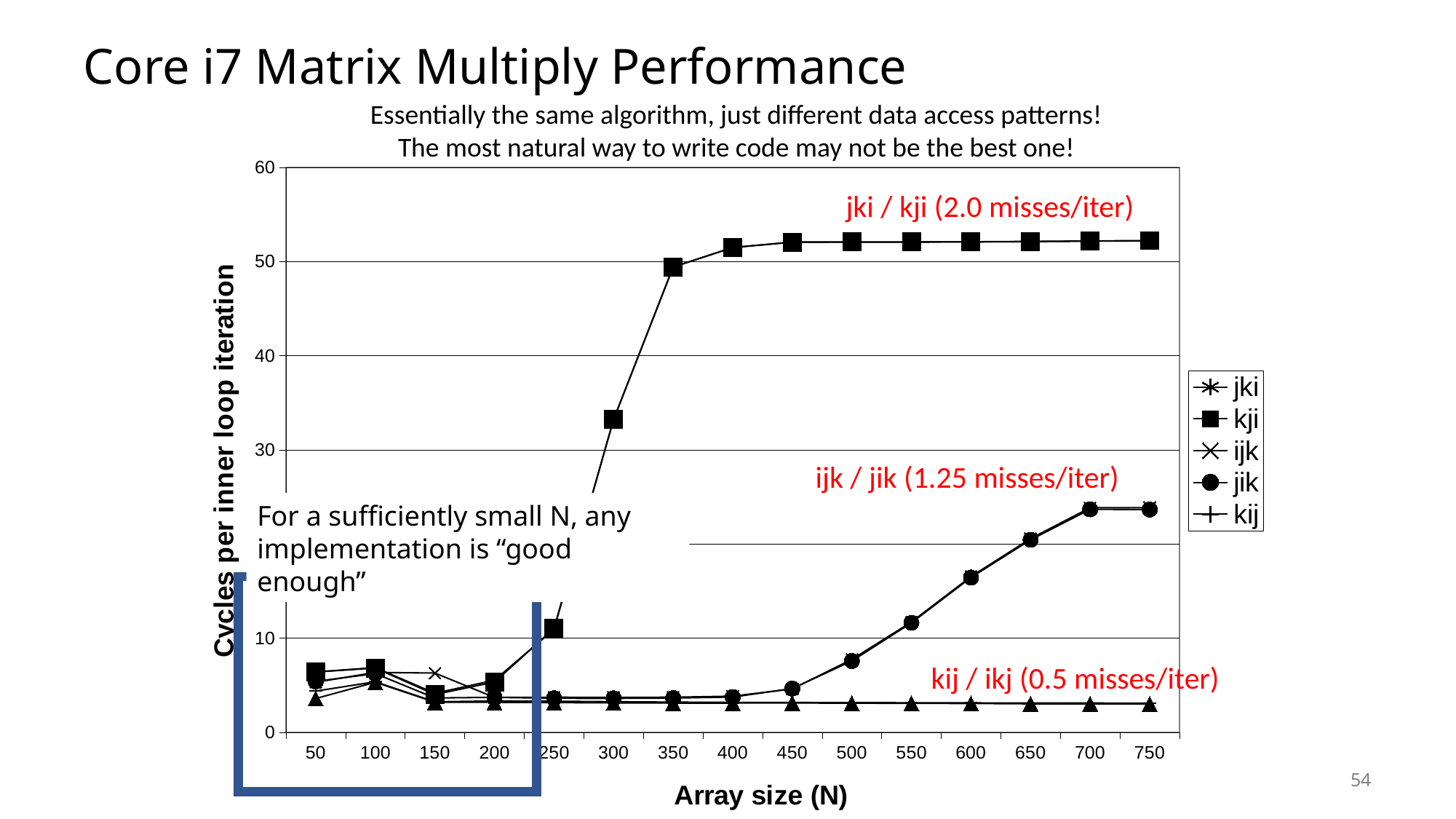
Is the value for kij at N = 750 greater or less than 10? less Is the value for kji at N = 750 greater or less than 50? greater How many array size (N) values are plotted along the x axis? 15 What is the label of the x axis? Array size (N) Is the value for kji at N = 300 greater or less than 30? greater What is the label of the y axis? Cycles per inner loop iteration At N = 750, which series has the higher value, kji or jik? kji How many series does the legend list? 5 At N = 600, which series has the lower value, jik or kij? kij What kind of chart is shown on the slide? line chart Which series has the highest value at N = 500? kji